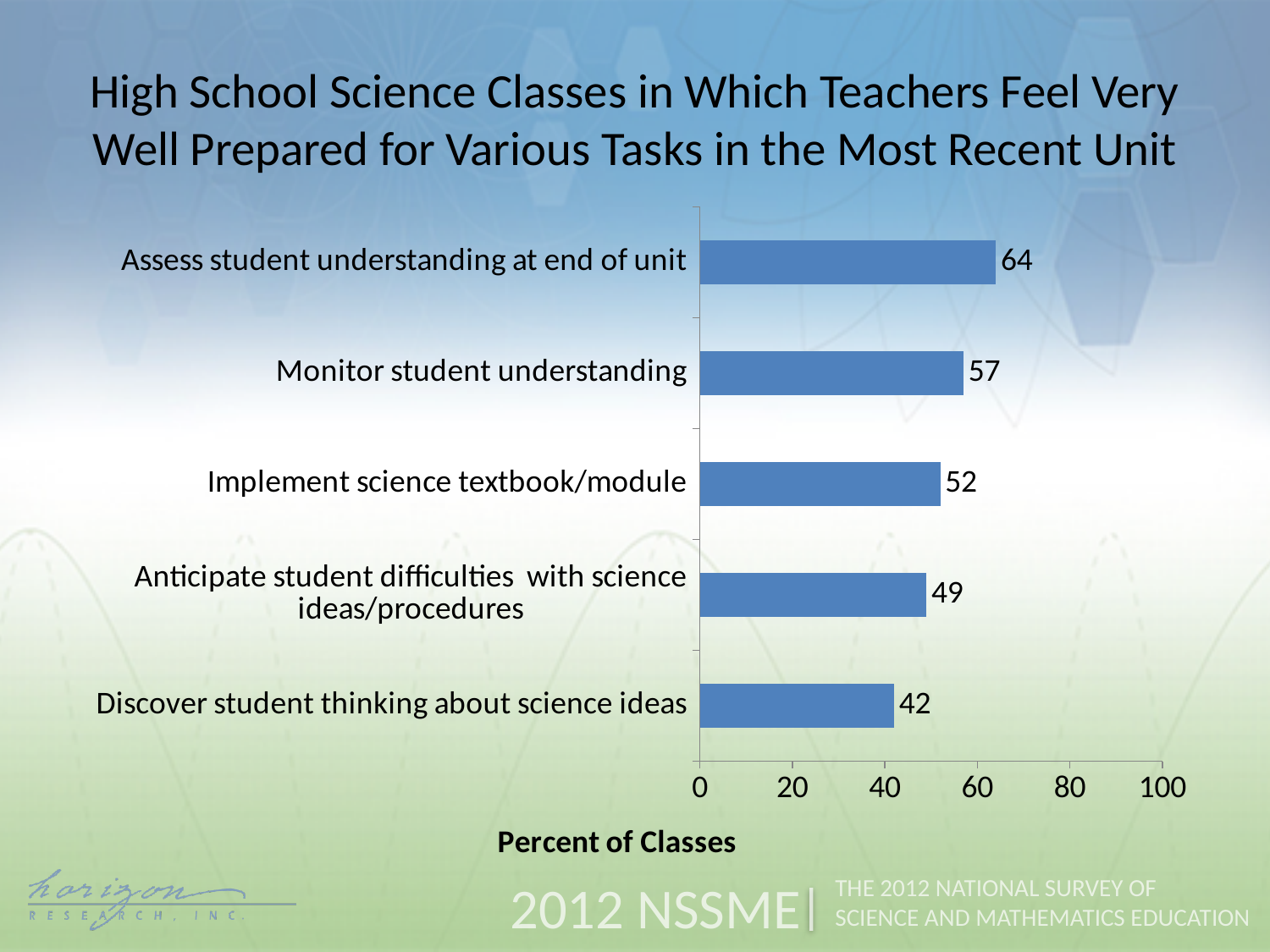
How many tasks (categories) are shown in the chart? 5 What is the difference between the values for "Implement science textbook/module" and "Anticipate student difficulties with science ideas/procedures"? 3 Which is larger: the value for "Monitor student understanding" or "Implement science textbook/module"? Monitor student understanding Which task has the lowest percent of classes? Discover student thinking about science ideas Which task has the highest percent of classes? Assess student understanding at end of unit What is the value for "Monitor student understanding"? 57 Is the value for "Anticipate student difficulties with science ideas/procedures" greater or less than 60? less What kind of chart is shown on the slide? Bar chart What percent of classes is shown for "Assess student understanding at end of unit"? 64 What is the label of the horizontal axis? Percent of Classes What is the value for "Discover student thinking about science ideas"? 42 What is the difference between the values for "Assess student understanding at end of unit" and "Discover student thinking about science ideas"? 22